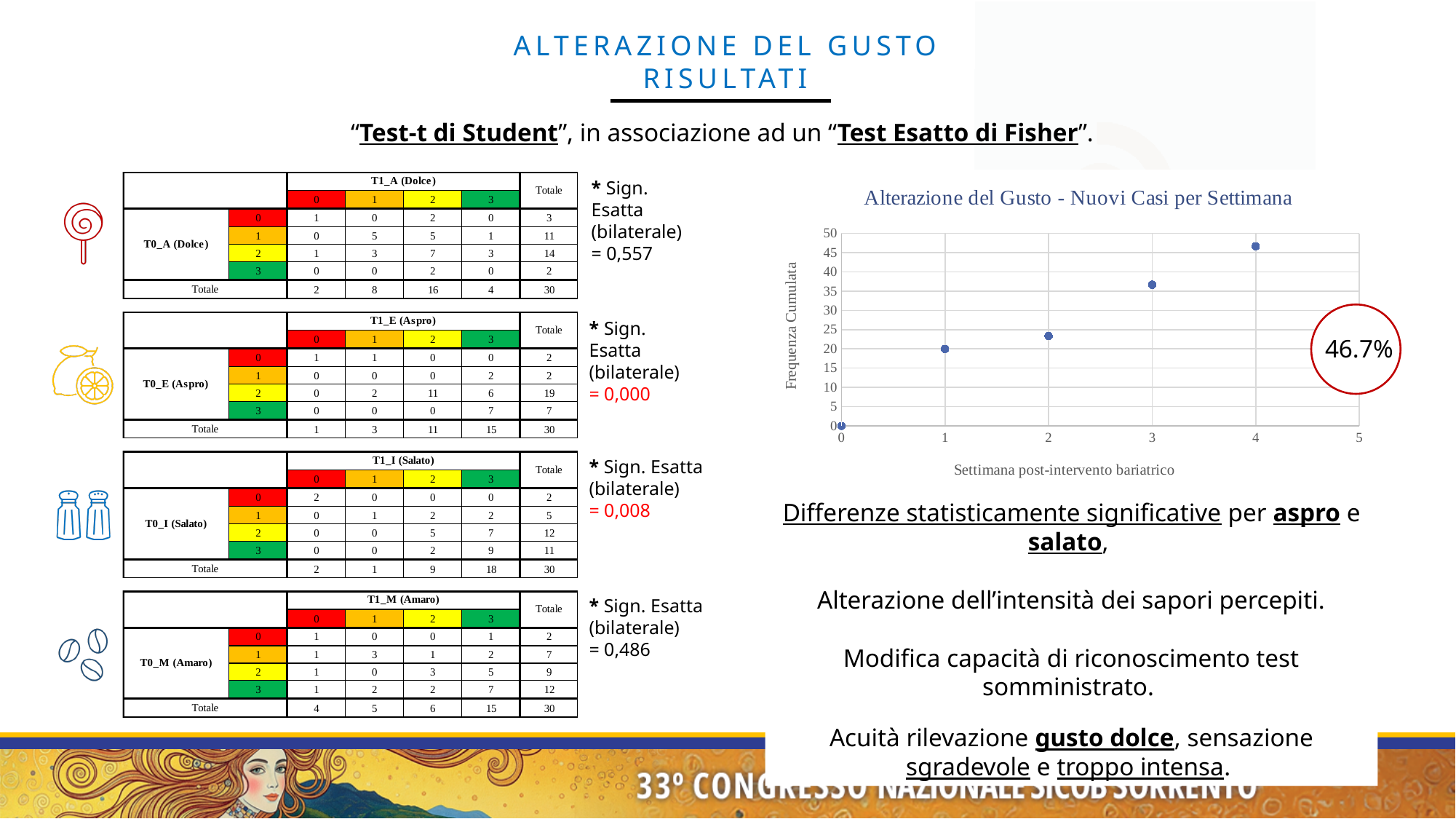
What kind of chart is shown on the right side of the slide? scatter chart Do the values in the chart rise or fall as the week number increases? rise What is the title of the chart on the slide? Alterazione del Gusto - Nuovi Casi per Settimana Is the cumulative frequency at week 4 greater or less than 40? greater What is the label of the vertical axis of the chart? Frequenza Cumulata At which week is the cumulative frequency highest in the chart? 4 Is the cumulative frequency at week 3 greater or less than 30? greater Is the cumulative frequency at week 2 greater or less than 25? less At which week is the cumulative frequency lowest in the chart? 0 What is the cumulative frequency plotted at week 0? 0 How many data points are plotted in the chart? 5 Which has the higher cumulative frequency in the chart, week 2 or week 3? week 3